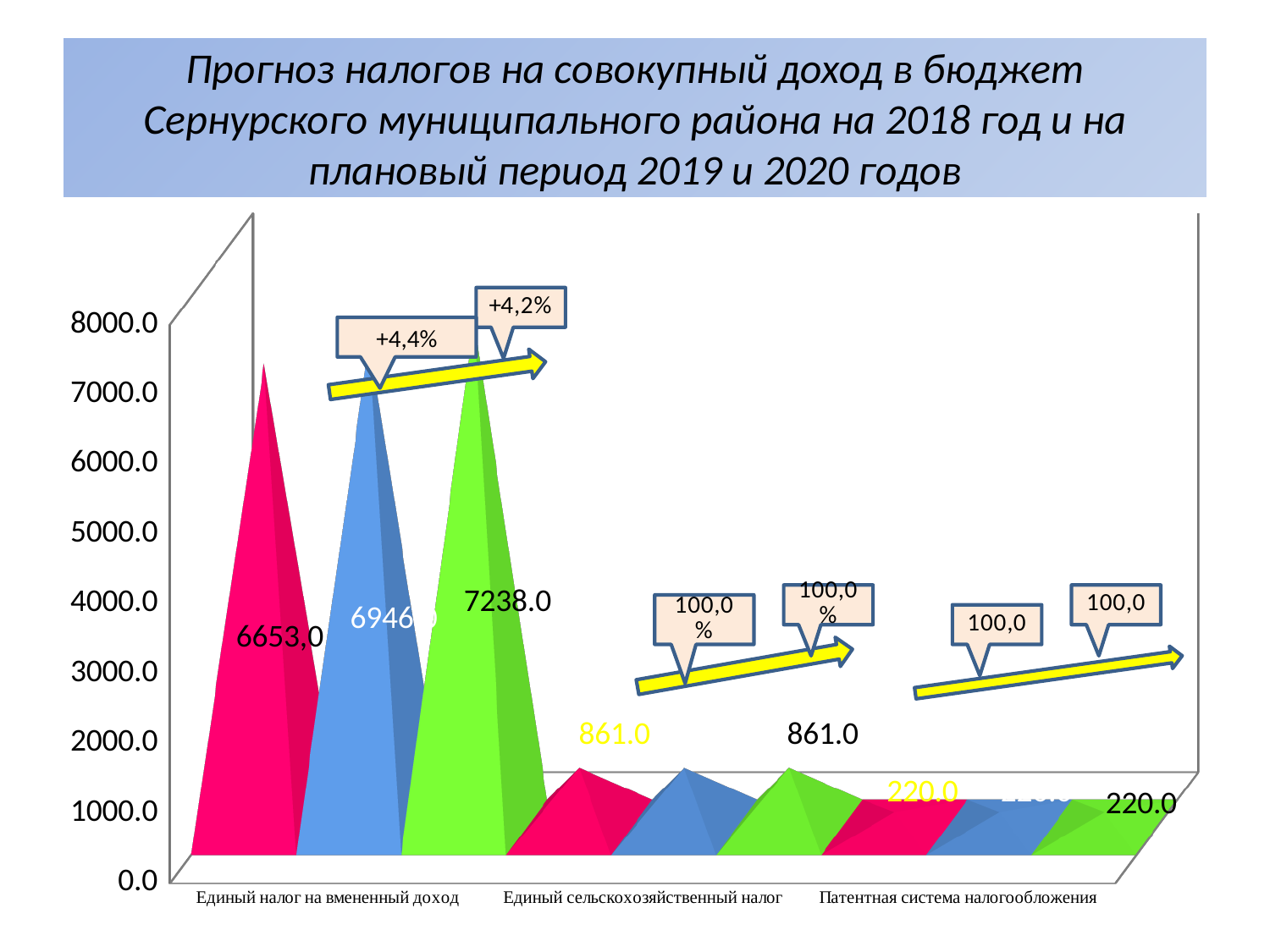
For Единый налог на вмененный доход, which is larger: the pink bar or the green bar? the green bar What is the value of the pink (first) bar for Единый налог на вмененный доход? 6653,0 What value is labelled for Патентная система налогообложения? 220.0 What value is labelled for Единый сельскохозяйственный налог? 861.0 What percentage changes are shown in the callouts above the Единый налог на вмененный доход bars? +4,4% and +4,2% How many categories are shown on the x axis of the chart? 3 What kind of chart is shown on the slide? bar chart Is the value for Единый сельскохозяйственный налог greater or less than 2000? less Which category has the lowest values in the chart? Патентная система налогообложения Which category has the highest values in the chart? Единый налог на вмененный доход What is the value of the green (third) bar for Единый налог на вмененный доход? 7238.0 What is the difference between the green bar (7238.0) and the pink bar (6653,0) for Единый налог на вмененный доход? 585.0